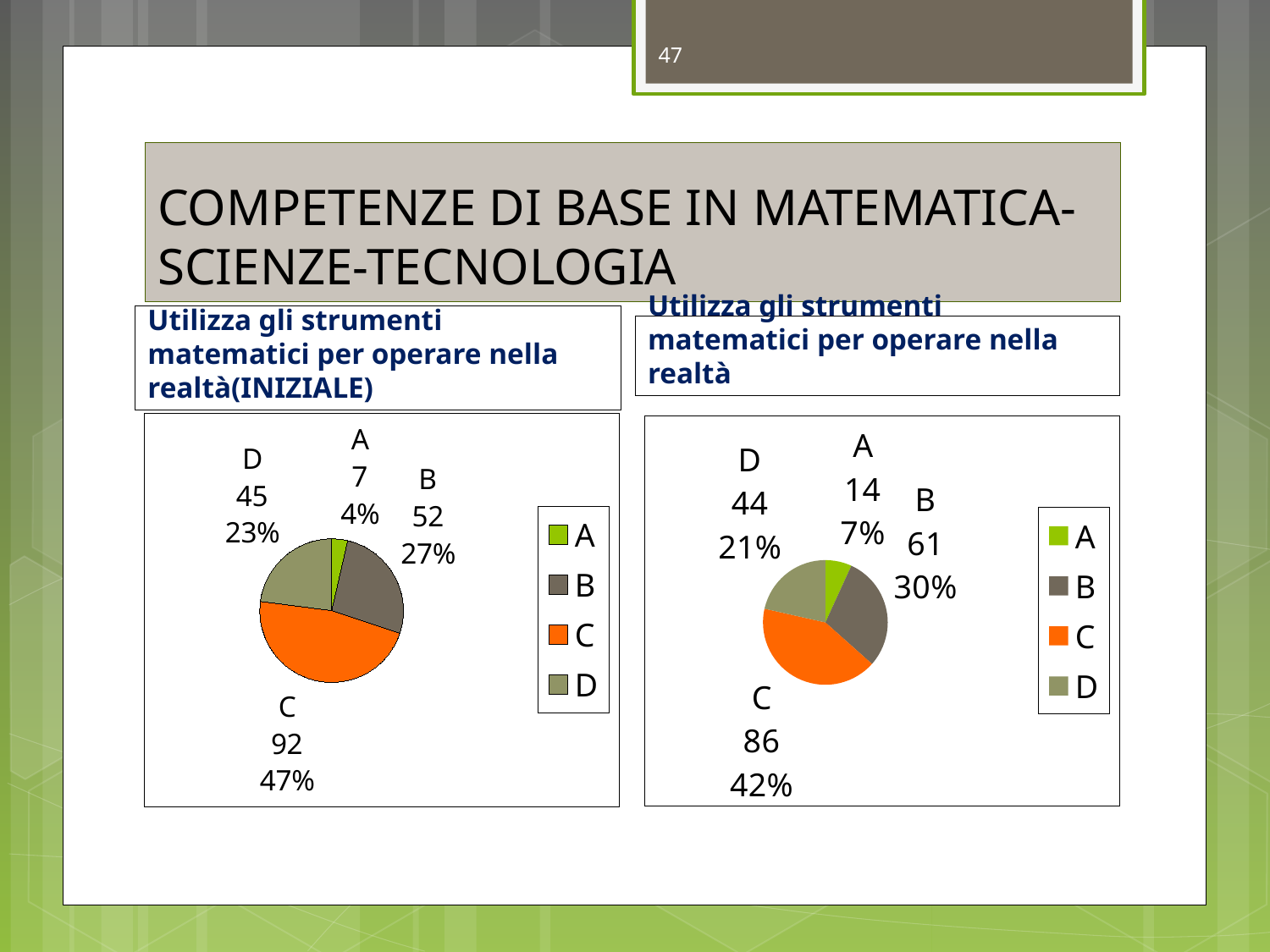
In the left pie chart (INIZIALE), what is the value for category C? 92 In the left pie chart (INIZIALE), which category has the largest slice? C In the right pie chart, which is larger, the value for D or the value for B? B In the left pie chart (INIZIALE), what is the difference between the values for B and D? 7 What type of chart is used on the right side of the slide? Pie chart In the right pie chart, which category has the smallest slice? A How many categories does the left pie chart (INIZIALE) show? 4 In the right pie chart, what is the difference between the values for C and B? 25 In the right pie chart, which colour represents category C in the legend? Orange In the right pie chart, what percentage share does category A have? 7% In the left pie chart (INIZIALE), what percentage share does category D have? 23% In the right pie chart, what is the value for category B? 61